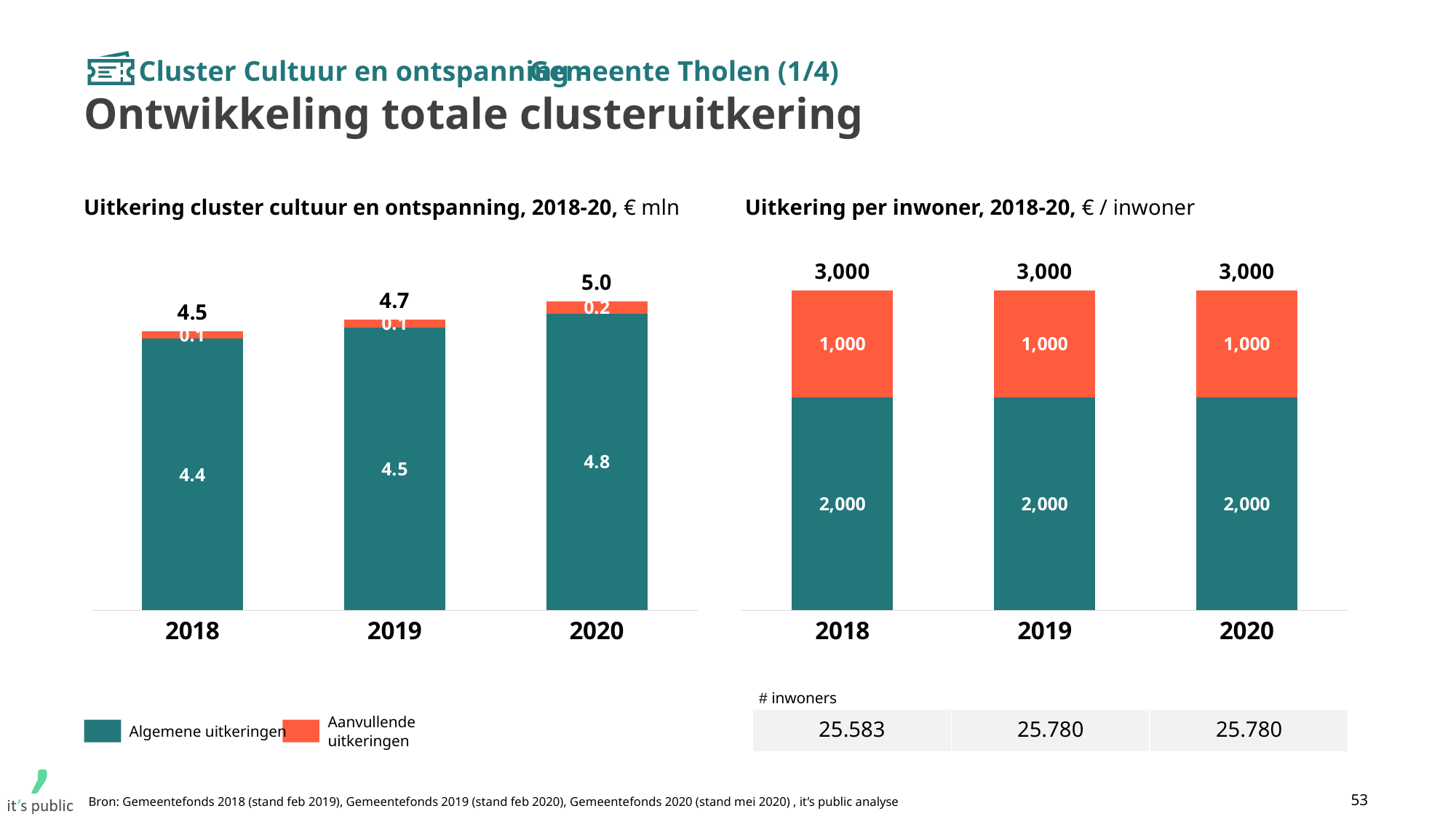
In the right chart 'Uitkering per inwoner, 2018-20', what is the value of Algemene uitkeringen in 2019? 2,000 In the left chart 'Uitkering cluster cultuur en ontspanning, 2018-20', which year has the highest total uitkering? 2020 In the left chart 'Uitkering cluster cultuur en ontspanning, 2018-20', what is the value of Aanvullende uitkeringen in 2020? 0.2 How many series does the legend on the slide list? 2 In the left chart 'Uitkering cluster cultuur en ontspanning, 2018-20', what is the value of Algemene uitkeringen in 2018? 4.4 In the left chart 'Uitkering cluster cultuur en ontspanning, 2018-20', what is the total uitkering for 2020? 5.0 In the left chart 'Uitkering cluster cultuur en ontspanning, 2018-20', do the total values rise or fall from 2018 to 2020? rise In the left chart 'Uitkering cluster cultuur en ontspanning, 2018-20', what is the difference between the total for 2020 and the total for 2018? 0.5 In the left chart 'Uitkering cluster cultuur en ontspanning, 2018-20', which year has the lowest total uitkering? 2018 What kind of chart is the left chart 'Uitkering cluster cultuur en ontspanning, 2018-20'? stacked bar chart In the right chart 'Uitkering per inwoner, 2018-20', what is the total uitkering per inwoner in 2018? 3,000 In the right chart 'Uitkering per inwoner, 2018-20', how many years are shown on the x axis? 3